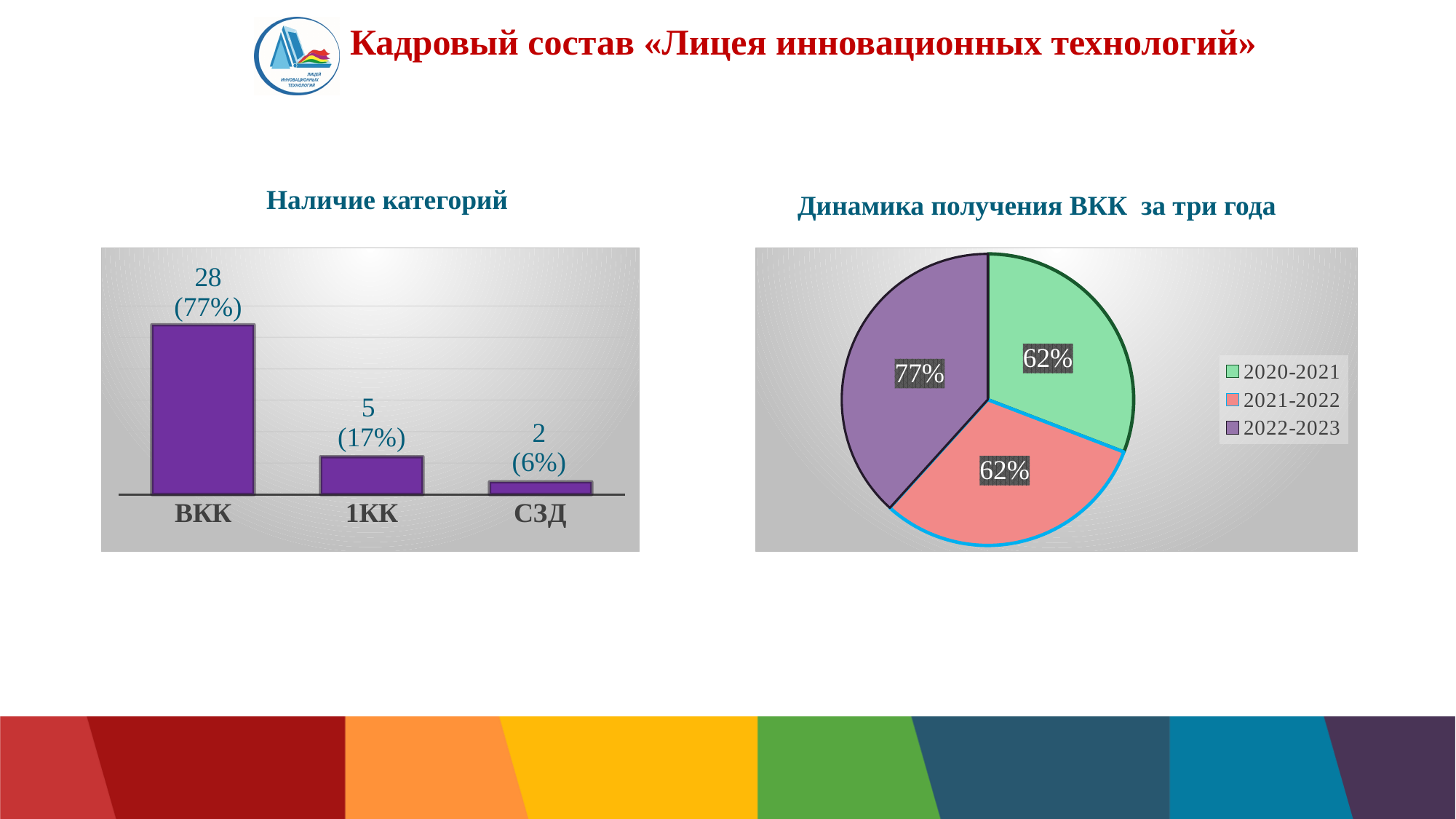
In the "Динамика получения ВКК за три года" chart, what percentage is shown for 2020-2021? 62% In the "Наличие категорий" chart, what value is shown for СЗД? 2 (6%) In the "Наличие категорий" chart, what value is shown for ВКК? 28 (77%) In the "Наличие категорий" chart, how many categories are shown? 3 In the "Наличие категорий" chart, which category has the lowest value? СЗД In the "Наличие категорий" chart, what value is shown for 1КК? 5 (17%) In the "Наличие категорий" chart, which category has the highest value? ВКК What type of chart is "Наличие категорий"? Bar chart In the "Наличие категорий" chart, what is the difference between the counts for ВКК and 1КК? 23 What type of chart is "Динамика получения ВКК за три года"? Pie chart How many entries does the legend of the "Динамика получения ВКК за три года" chart list? 3 In the "Динамика получения ВКК за три года" chart, what percentage is shown for 2022-2023? 77%